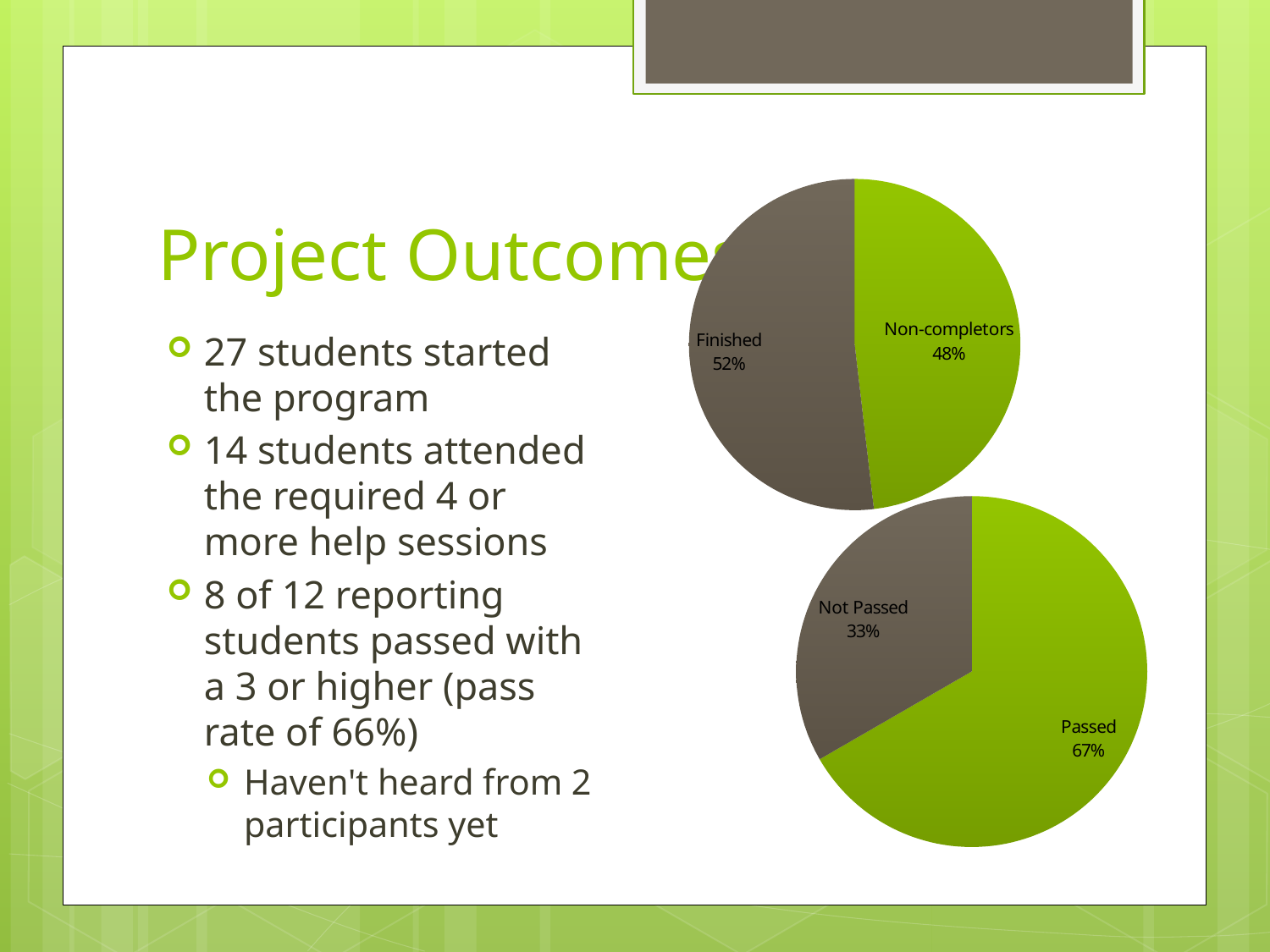
In the lower pie chart, which slice is the smallest? Not Passed In the upper pie chart, which slice is larger, Finished or Non-completors? Finished In the upper pie chart, what share is labelled Finished? 52% In the lower pie chart, what is the difference between the Passed and Not Passed shares? 34% How many slices does the lower pie chart have? 2 In the lower pie chart, what share is labelled Not Passed? 33% What kind of chart is the upper chart on the slide? Pie chart In the lower pie chart, which slice is the largest? Passed In the lower pie chart, what share is labelled Passed? 67% In the upper pie chart, what is the difference between the Finished and Non-completors shares? 4% In the upper pie chart, what share is labelled Non-completors? 48% In the lower pie chart, what colour is the Passed slice? Green